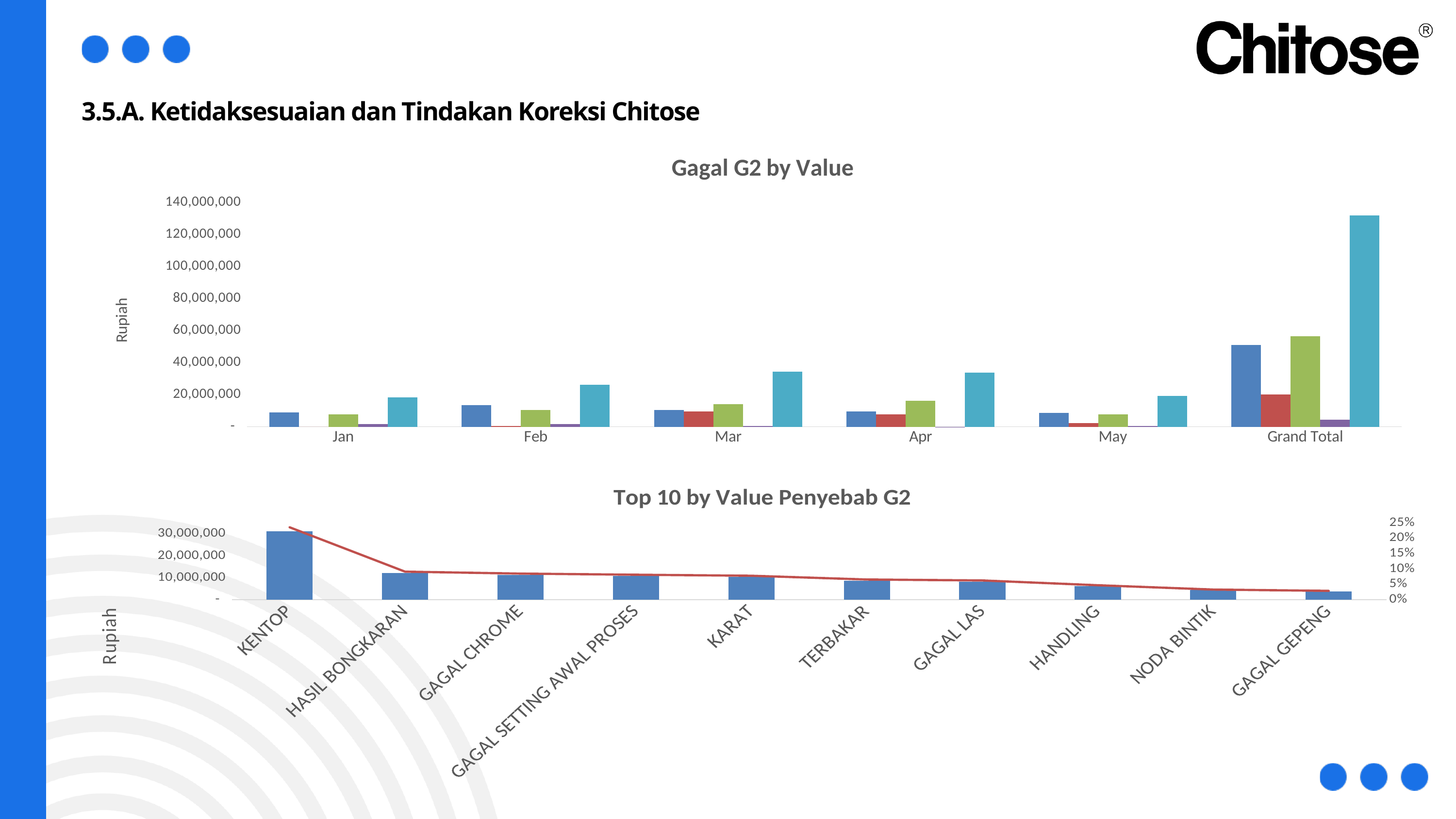
In the 'Top 10 by Value Penyebab G2' chart, which category has the lowest bar? GAGAL GEPENG In the 'Top 10 by Value Penyebab G2' chart, how many categories are shown on the x axis? 10 In the 'Top 10 by Value Penyebab G2' chart, do the bar values rise or fall from left to right along the x axis? fall In the 'Gagal G2 by Value' chart, what kind of chart is shown? bar chart What is the title of the top chart on the slide? Gagal G2 by Value In the 'Top 10 by Value Penyebab G2' chart, which has the larger bar, HANDLING or GAGAL GEPENG? HANDLING In the 'Top 10 by Value Penyebab G2' chart, which category has the highest bar? KENTOP In the 'Gagal G2 by Value' chart, which category contains the tallest bar? Grand Total In the 'Gagal G2 by Value' chart, is the value of the tallest bar in the Jan group greater or less than 20,000,000? less In the 'Gagal G2 by Value' chart, how many categories are shown on the x axis? 6 In the 'Gagal G2 by Value' chart, is the value of the tallest bar in the Grand Total group greater or less than 120,000,000? greater In the 'Top 10 by Value Penyebab G2' chart, is the bar value for KENTOP greater or less than 20,000,000? greater